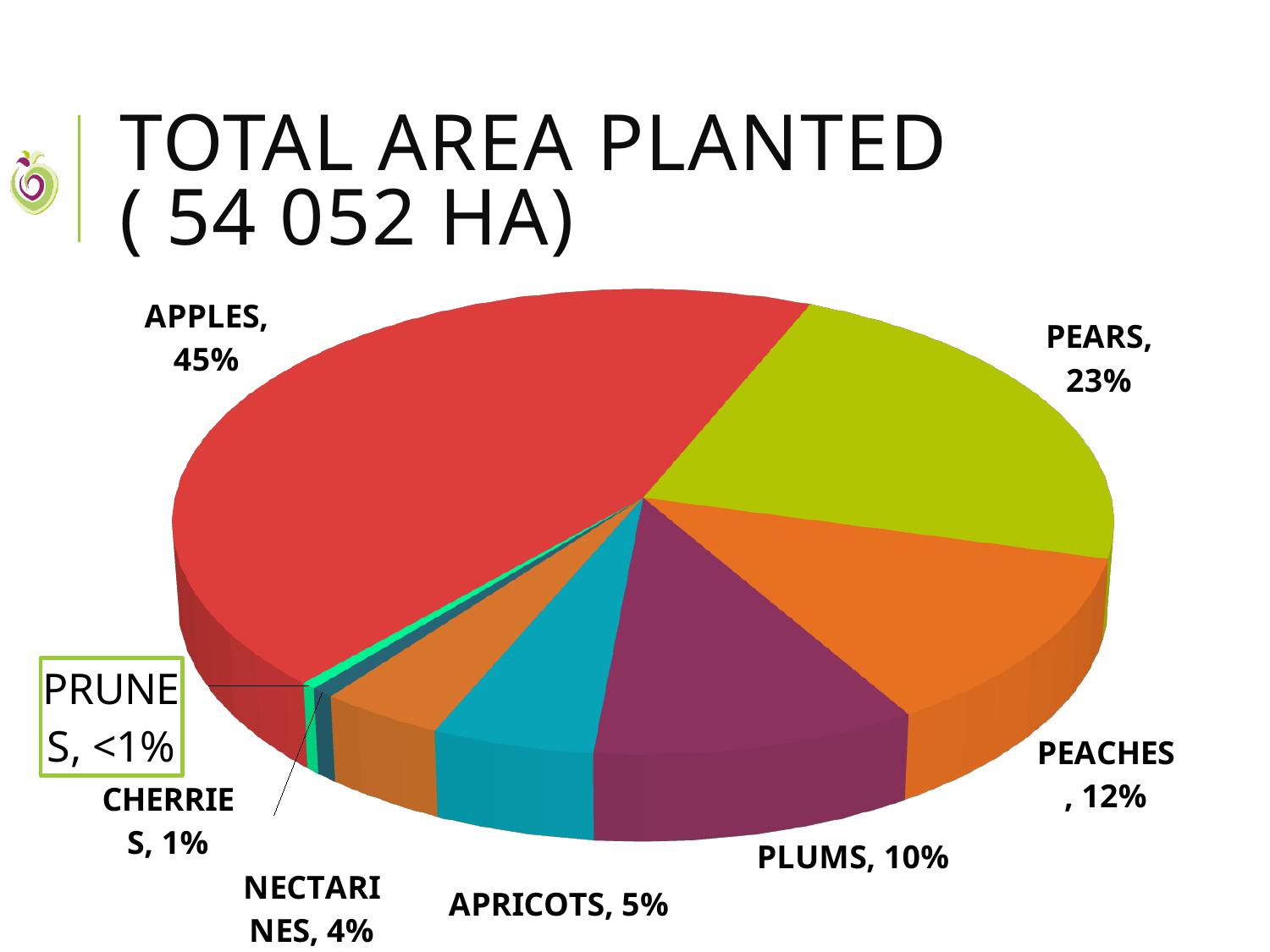
What percentage is shown for prunes? <1% Which fruit has the smallest share of the total area planted? Prunes Which fruit has the largest share of the total area planted? Apples What total area in hectares is given in the chart title? 54 052 HA What share of the total area planted is apples? 45% What share of the total area planted is pears? 23% Which has a larger share, plums or apricots? Plums What percentage is shown for peaches? 12% What percentage is shown for nectarines? 4% How many fruit categories are shown in the pie chart? 8 What kind of chart is shown on the slide? Pie chart How many percentage points larger is the apples share than the pears share? 22